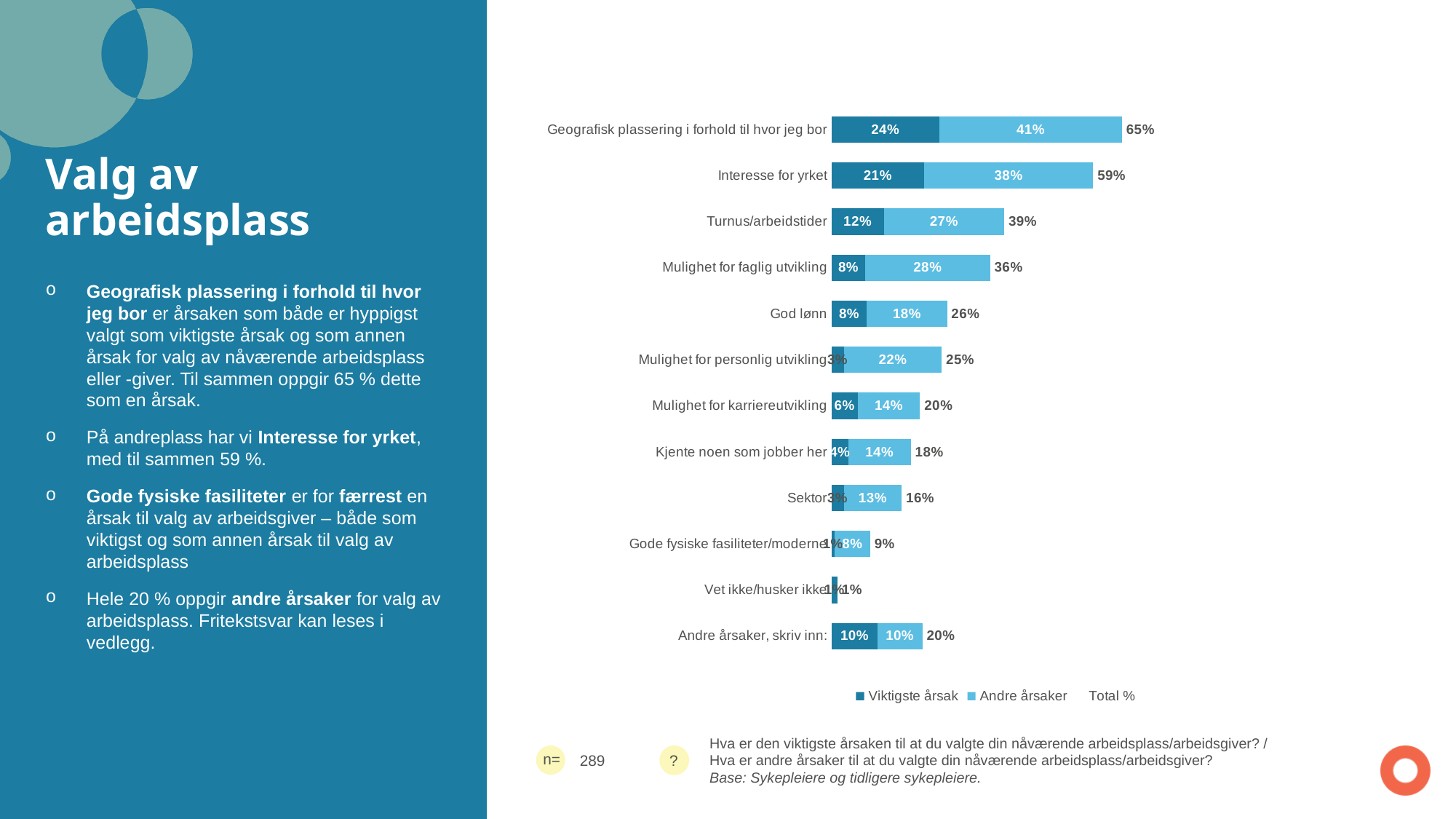
What is the 'Viktigste årsak' value for 'Mulighet for karriereutvikling'? 6% Which is larger: the 'Andre årsaker' value for 'Mulighet for faglig utvikling' or for 'God lønn'? Mulighet for faglig utvikling What is the difference between the total for 'Geografisk plassering i forhold til hvor jeg bor' and the total for 'Interesse for yrket'? 6% How many entries does the legend list? 3 What kind of chart is shown on the slide? bar chart How many categories are plotted in the chart? 12 What is the total percentage shown for 'Turnus/arbeidstider'? 39% What is the 'Viktigste årsak' value for 'Geografisk plassering i forhold til hvor jeg bor'? 24% What is the total of the stacked bar for 'Andre årsaker, skriv inn:'? 20% What is the 'Andre årsaker' value for 'Interesse for yrket'? 38% Which category has the lowest total percentage? Vet ikke/husker ikke Which category has the highest total percentage? Geografisk plassering i forhold til hvor jeg bor